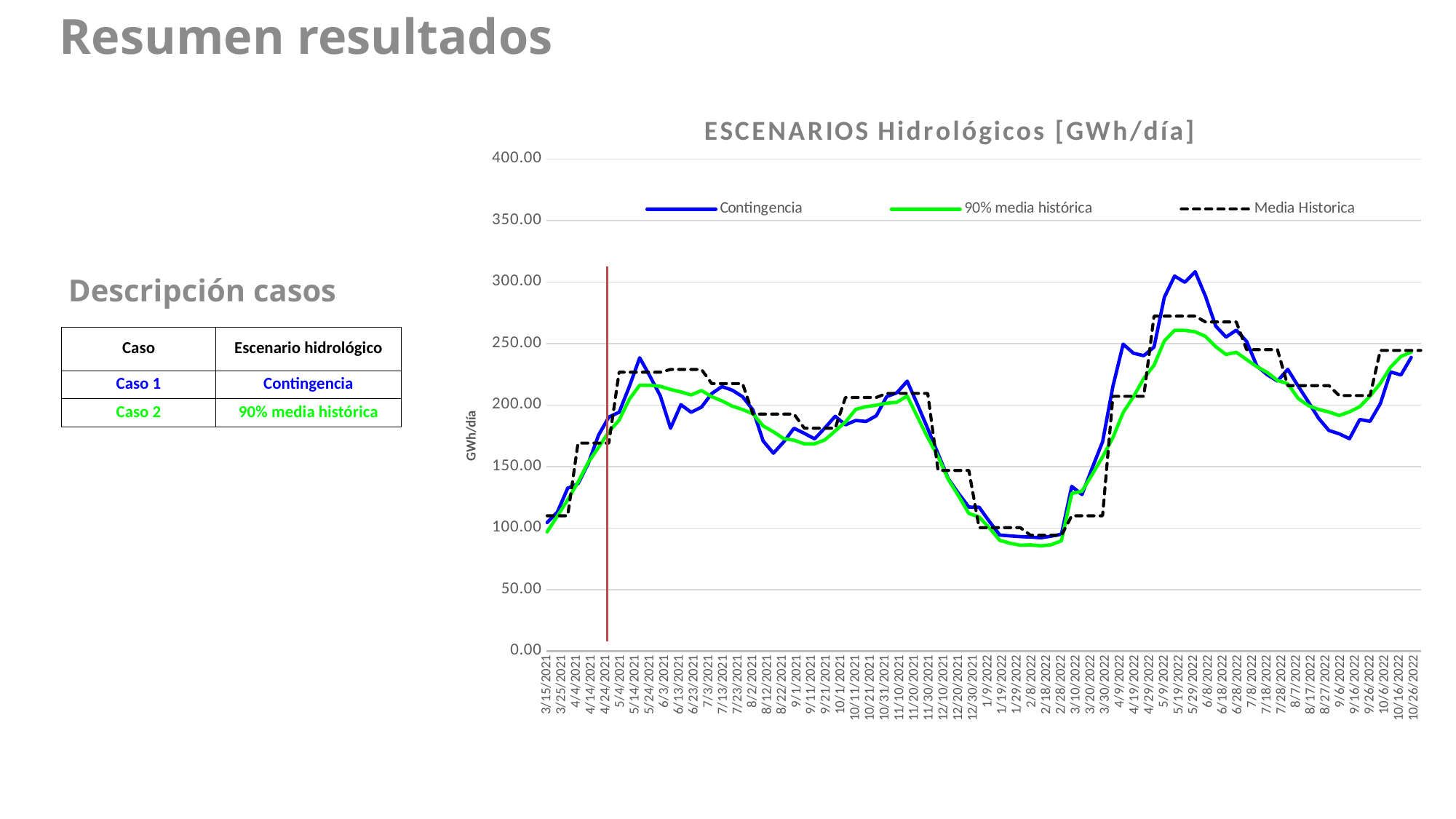
Is the value of Media Historica at 5/19/2022 greater or less than 250? greater How many series does the chart legend list? 3 Between 11/20/2021 and 2/8/2022, does the Contingencia series rise or fall? fall What kind of chart is shown on the slide? line chart Which series in the chart is drawn as a dashed line? Media Historica At 3/30/2022, which series has the higher value, Contingencia or Media Historica? Contingencia What is the title of the chart? ESCENARIOS Hidrológicos [GWh/día] At 5/29/2022, which series has the higher value, Contingencia or 90% media histórica? Contingencia Is the value of 90% media histórica at 2/8/2022 greater or less than 100? less Which series reaches the highest peak value in the chart? Contingencia Is the value of Contingencia at 9/16/2022 greater or less than 200? less